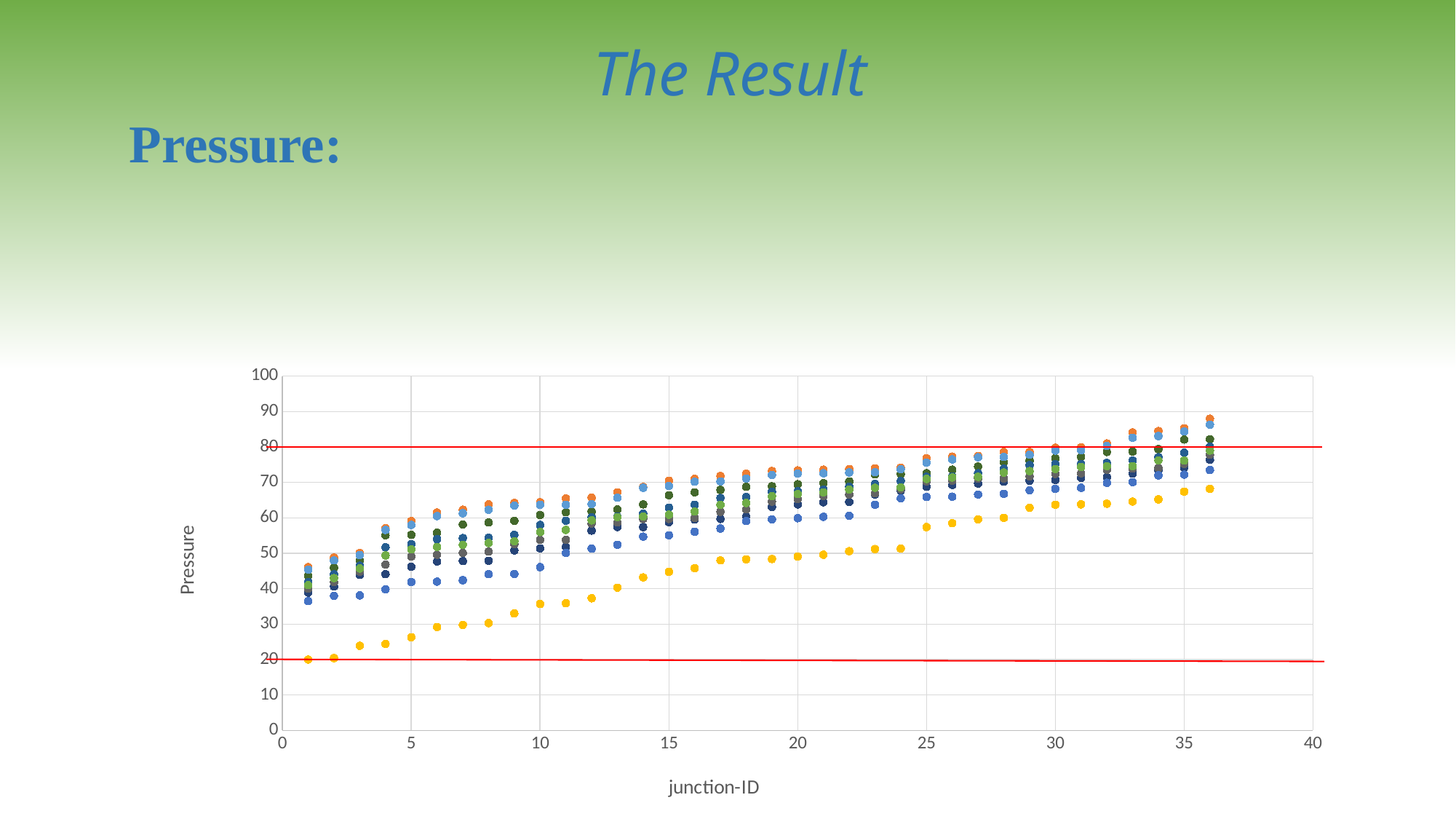
Is the highest plotted pressure at junction-ID 36 greater or less than 80? greater Do the pressure values rise or fall as junction-ID increases? rise Is the highest plotted pressure at junction-ID 15 greater or less than 60? greater Is the yellow series value at junction-ID 10 greater or less than 40? less What is the label of the vertical axis? Pressure At what two pressure values are the red horizontal lines drawn? 80 and 20 What kind of chart is shown on the slide? scatter chart Which series has the lowest pressure values across the junction-IDs? the yellow series For the yellow series, is the pressure larger at junction-ID 36 or at junction-ID 1? junction-ID 36